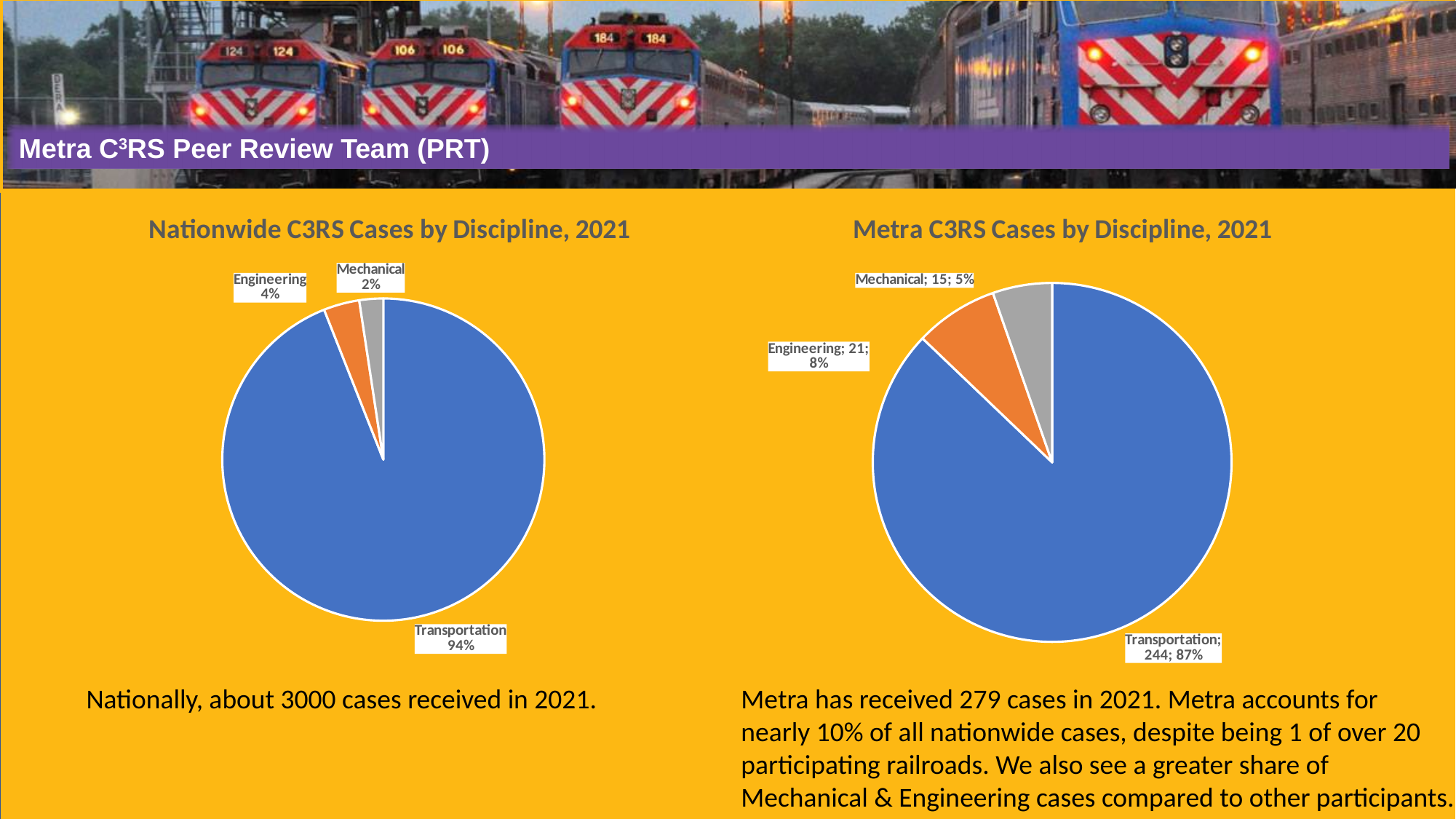
In the 'Nationwide C3RS Cases by Discipline, 2021' chart, what share of cases is Transportation? 94% In the 'Metra C3RS Cases by Discipline, 2021' chart, what share of cases is Mechanical? 5% In the 'Metra C3RS Cases by Discipline, 2021' chart, how many more Engineering cases are there than Mechanical cases? 6 How many disciplines are shown in the 'Nationwide C3RS Cases by Discipline, 2021' chart? 3 What type of chart is 'Metra C3RS Cases by Discipline, 2021'? Pie chart In the 'Nationwide C3RS Cases by Discipline, 2021' chart, which discipline has the smallest slice? Mechanical In the 'Metra C3RS Cases by Discipline, 2021' chart, which has more cases, Engineering or Mechanical? Engineering In the 'Metra C3RS Cases by Discipline, 2021' chart, how many cases are Transportation? 244 In the 'Metra C3RS Cases by Discipline, 2021' chart, which discipline has the largest slice? Transportation In the 'Nationwide C3RS Cases by Discipline, 2021' chart, what share of cases is Mechanical? 2% In the 'Metra C3RS Cases by Discipline, 2021' chart, how many cases are Engineering? 21